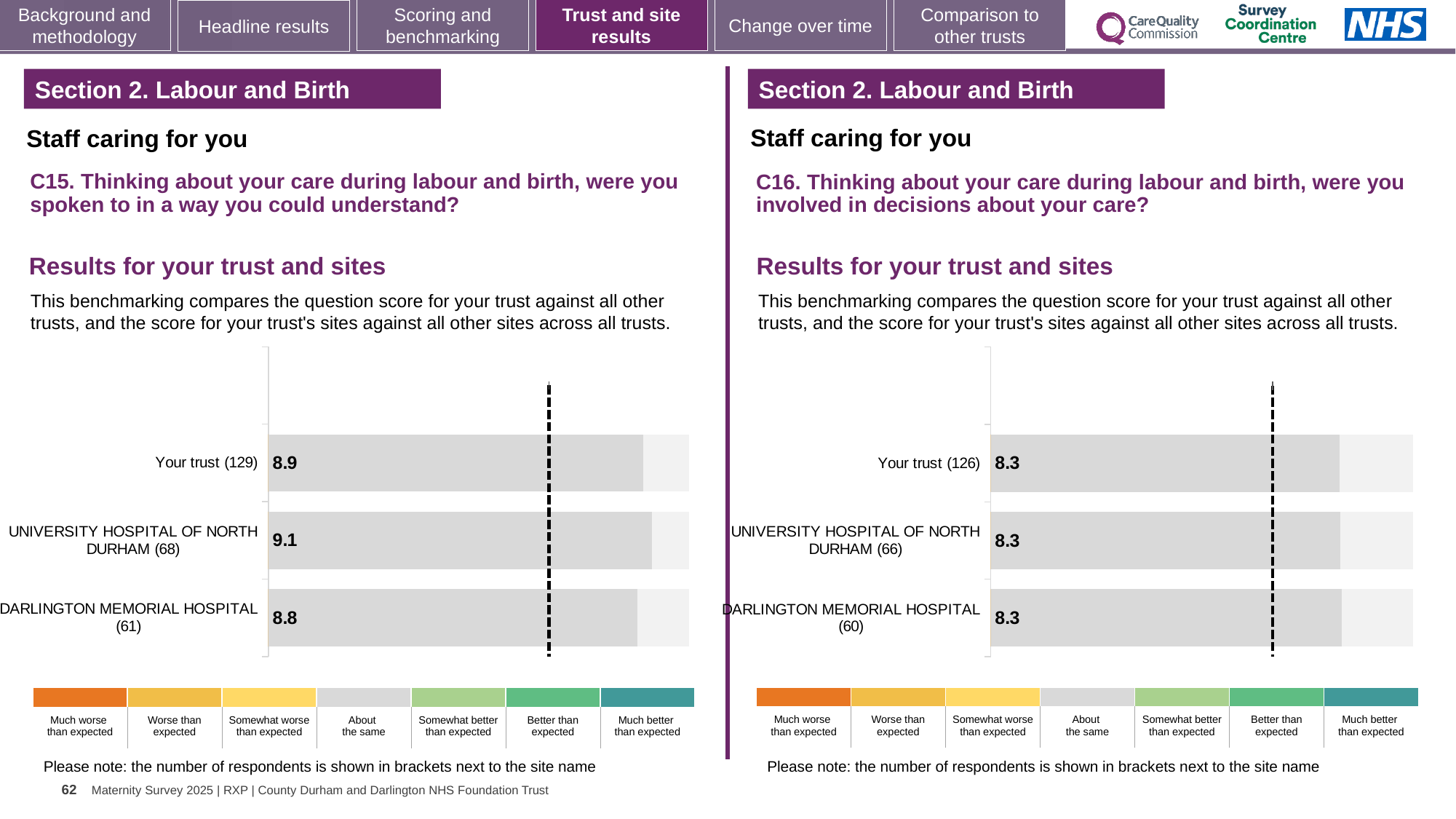
On the C16 chart (right), how many bars are plotted? 3 On the C15 chart (left), what is the score for DARLINGTON MEMORIAL HOSPITAL (61)? 8.8 On the C16 chart (right), how many respondents are shown in brackets for UNIVERSITY HOSPITAL OF NORTH DURHAM? 66 On the C15 chart (left), which site or trust has the highest score? UNIVERSITY HOSPITAL OF NORTH DURHAM (68) On the C16 chart (right), what is the score for Your trust (126)? 8.3 On the C15 chart (left), what is the score for UNIVERSITY HOSPITAL OF NORTH DURHAM (68)? 9.1 On the C15 chart (left), which site or trust has the lowest score? DARLINGTON MEMORIAL HOSPITAL (61) On the C15 chart (left), which has the larger score: Your trust (129) or UNIVERSITY HOSPITAL OF NORTH DURHAM (68)? UNIVERSITY HOSPITAL OF NORTH DURHAM (68) On the C16 chart (right), what is the score for DARLINGTON MEMORIAL HOSPITAL (60)? 8.3 What kind of chart is used on the C15 chart (left)? Bar chart On the C15 chart (left), what is the score for Your trust (129)? 8.9 On the C15 chart (left), what is the difference between the scores for UNIVERSITY HOSPITAL OF NORTH DURHAM (68) and DARLINGTON MEMORIAL HOSPITAL (61)? 0.3